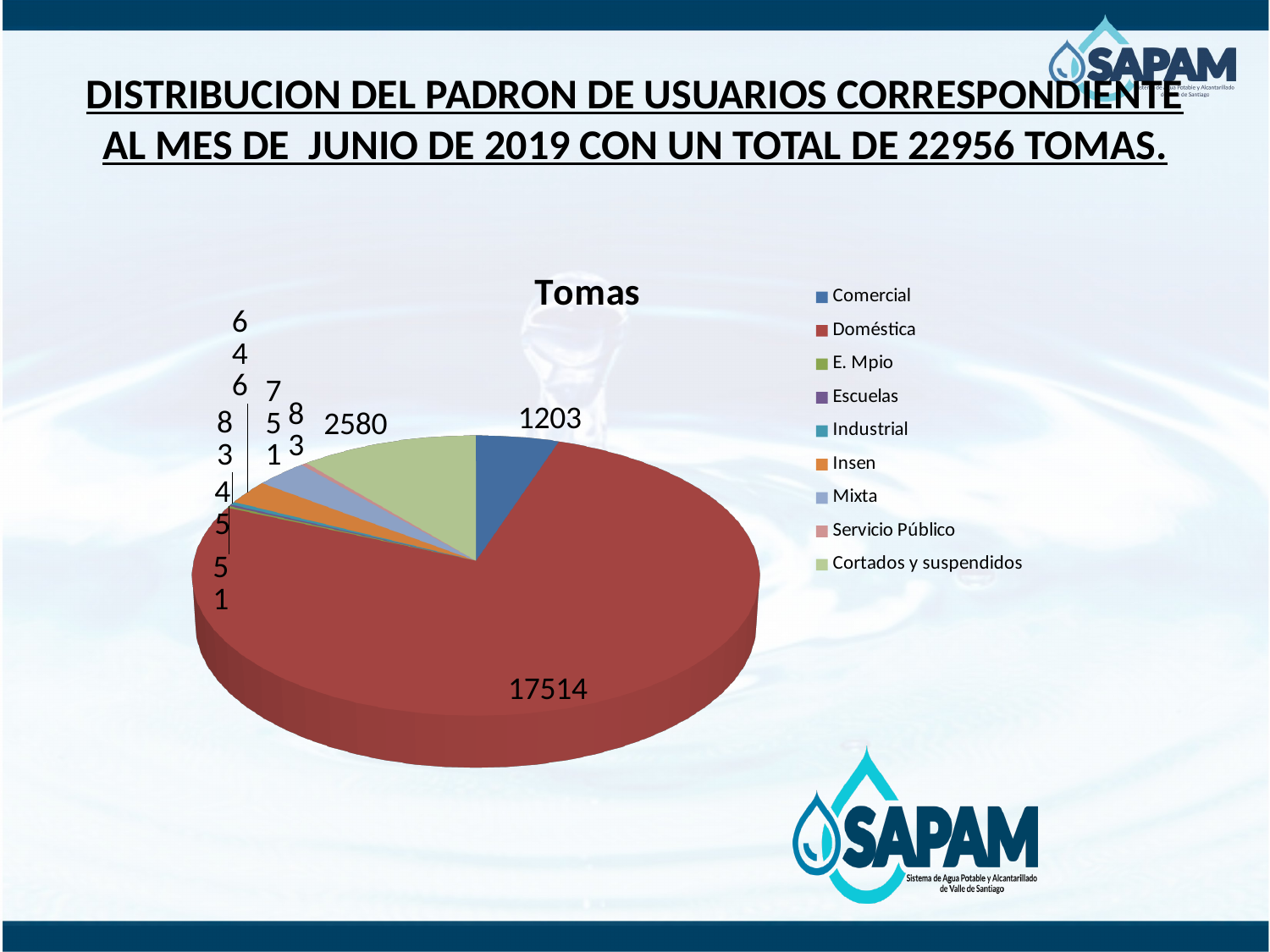
Which is larger, Comercial or Cortados y suspendidos? Cortados y suspendidos What is the difference between Cortados y suspendidos and Comercial? 1377 How many categories does the legend of the chart list? 9 What is the title of the chart? Tomas Which category has the largest slice of the pie? Doméstica What colour is the Doméstica slice? red What is the value for Cortados y suspendidos? 2580 What type of chart is shown on the slide? pie chart What is the value for Doméstica? 17514 What is the difference between Doméstica and Comercial? 16311 Given the total of 22956 tomas stated in the slide title, what share of the pie does Doméstica represent? 76.3% What is the value for Comercial? 1203